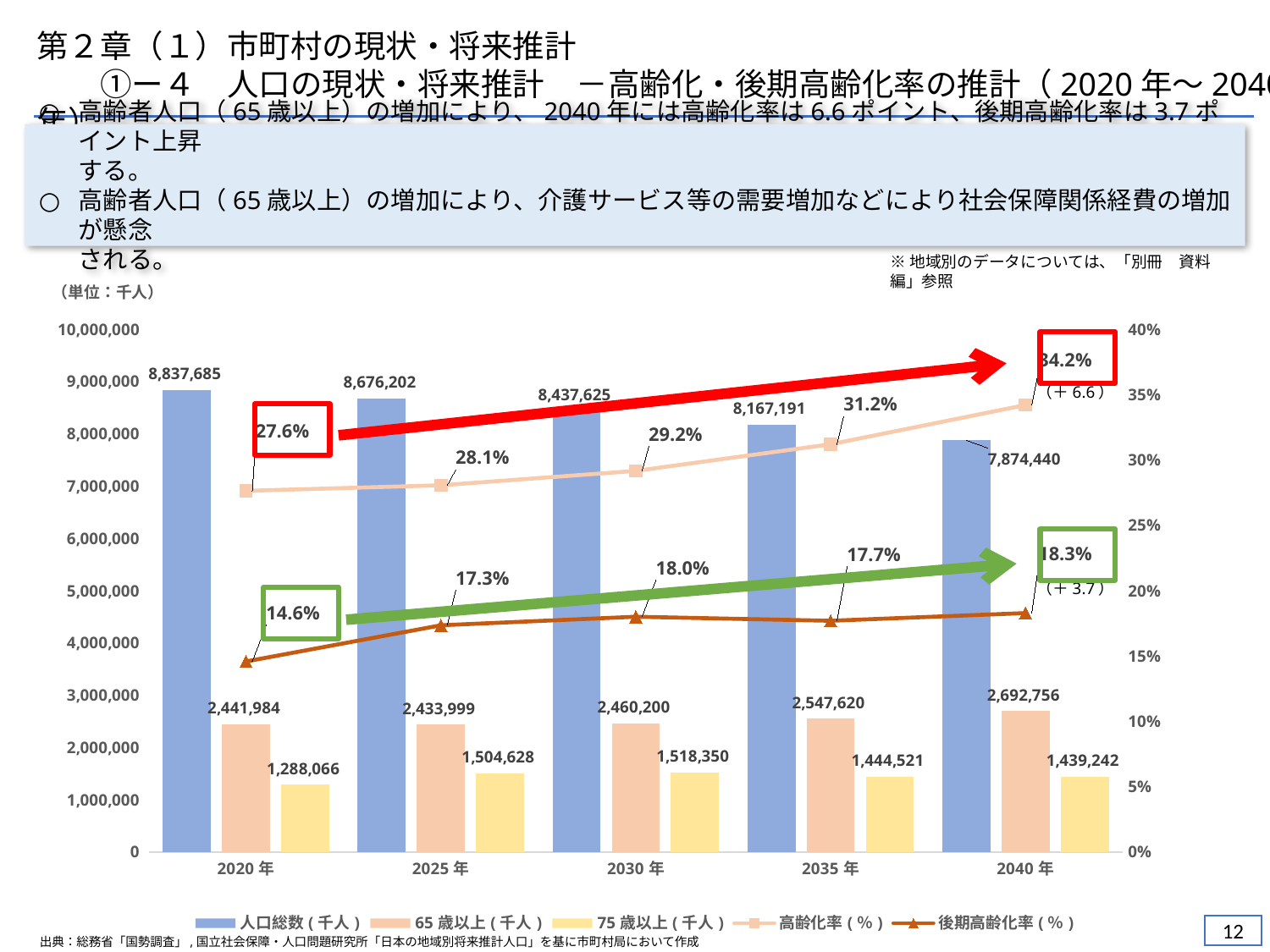
What kind of chart is this? Combined bar and line chart What is the value of 65歳以上 for 2040年? 2,692,756 What is the difference between 人口総数 in 2020年 and 2040年? 963,245 Does 人口総数 rise or fall from 2020年 to 2040年? fall In which year is 人口総数 lowest? 2040年 In which year is 75歳以上 highest? 2030年 Which is larger, 65歳以上 in 2025年 or 65歳以上 in 2035年? 2035年 What is the 後期高齢化率 for 2020年? 14.6% What is the 高齢化率 for 2035年? 31.2% How many years are shown on the x axis? 5 What is the value of 人口総数 for 2020年? 8,837,685 How many series does the legend list? 5